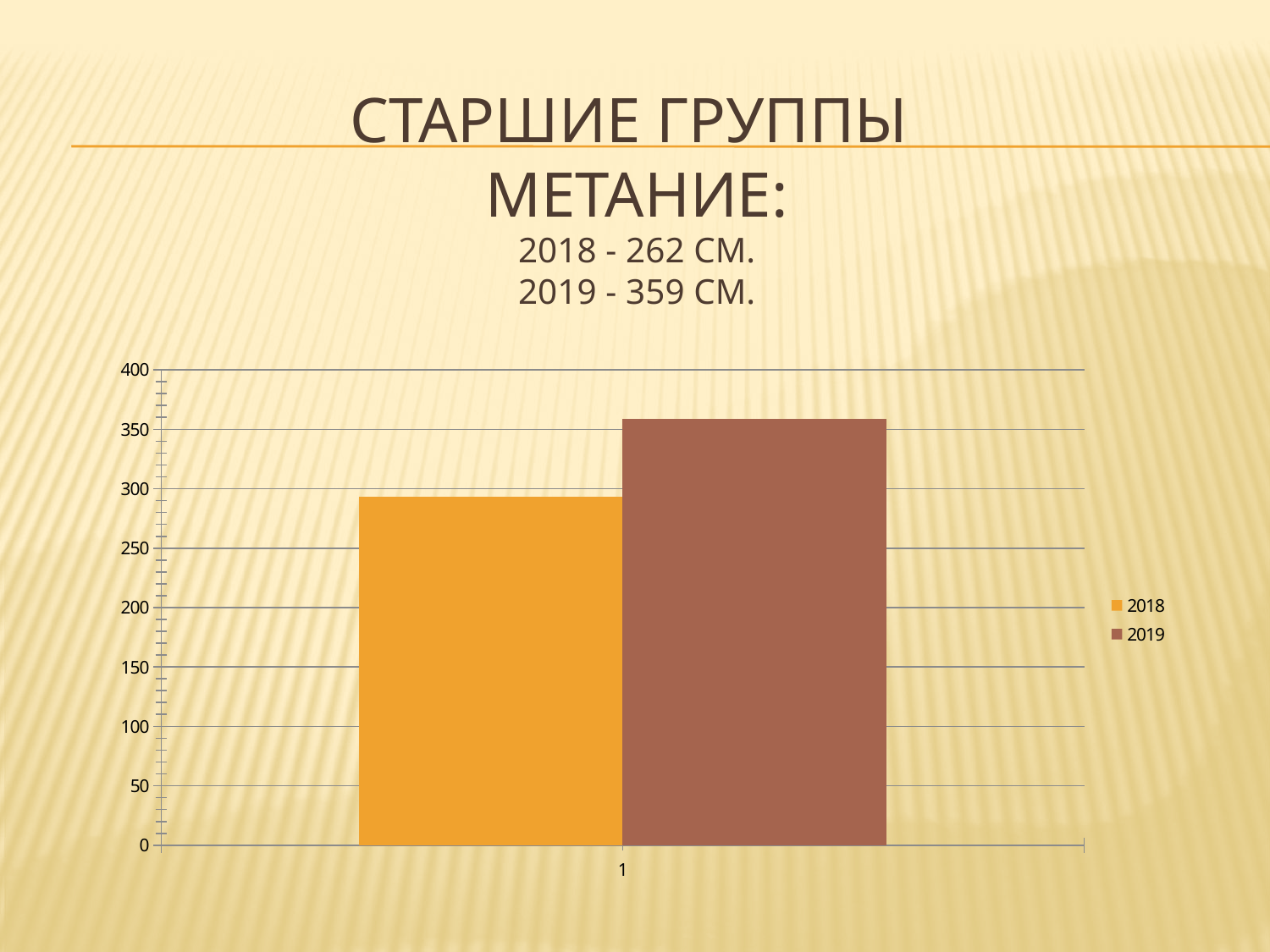
Which series has the lowest bar? 2018 What are the entries in the chart legend? 2018, 2019 Is the value for 2019 greater or less than 300? greater Is the value for 2018 greater or less than 250? greater Which is larger, the value for 2018 or the value for 2019? 2019 According to the slide, what is the throwing result for 2019? 359 см Which series has the highest bar, 2018 or 2019? 2019 How many categories are shown on the x axis? 1 What kind of chart is shown on the slide? bar chart What colour is the bar for the 2018 series? orange Is the value for 2019 greater or less than 400? less How many series does the legend list? 2